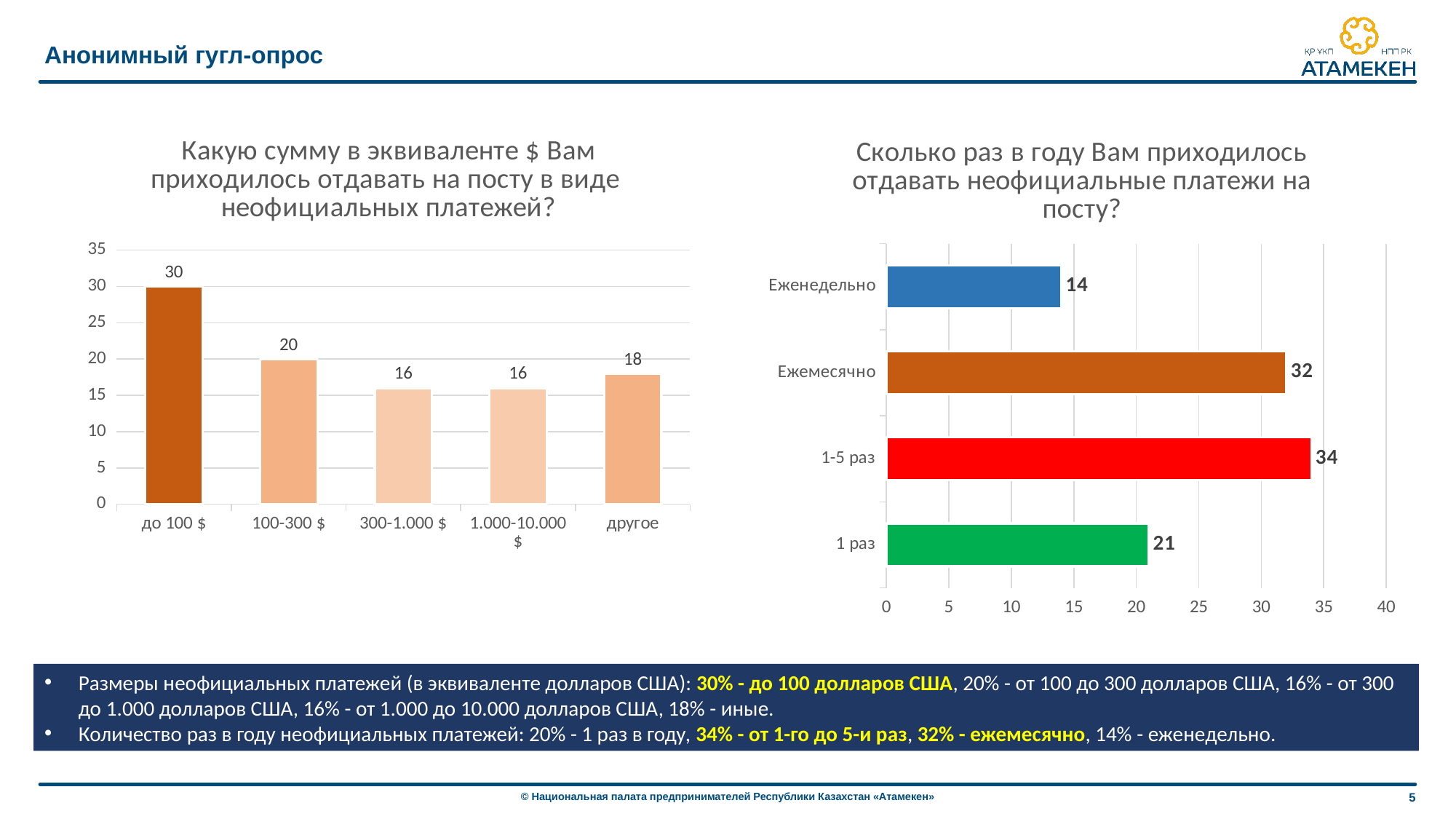
In the left chart, what is the difference between the values for "до 100 $" and "другое"? 12 In the right chart, which category has the lowest value? Еженедельно In the left chart, what is the value for "100-300 $"? 20 In the right chart, what is the value for "1 раз"? 21 In the left chart, which is larger: the value for "100-300 $" or the value for "другое"? 100-300 $ In the right chart, what is the difference between the values for "1-5 раз" and "Еженедельно"? 20 In the left chart, how many categories are shown on the x axis? 5 In the right chart, how many categories are shown? 4 What type of chart is the right chart? Bar chart In the left chart ("Какую сумму в эквиваленте $ Вам приходилось отдавать на посту в виде неофициальных платежей?"), what is the value for "до 100 $"? 30 In the right chart ("Сколько раз в году Вам приходилось отдавать неофициальные платежи на посту?"), what is the value for "Ежемесячно"? 32 In the left chart, which category has the highest value? до 100 $